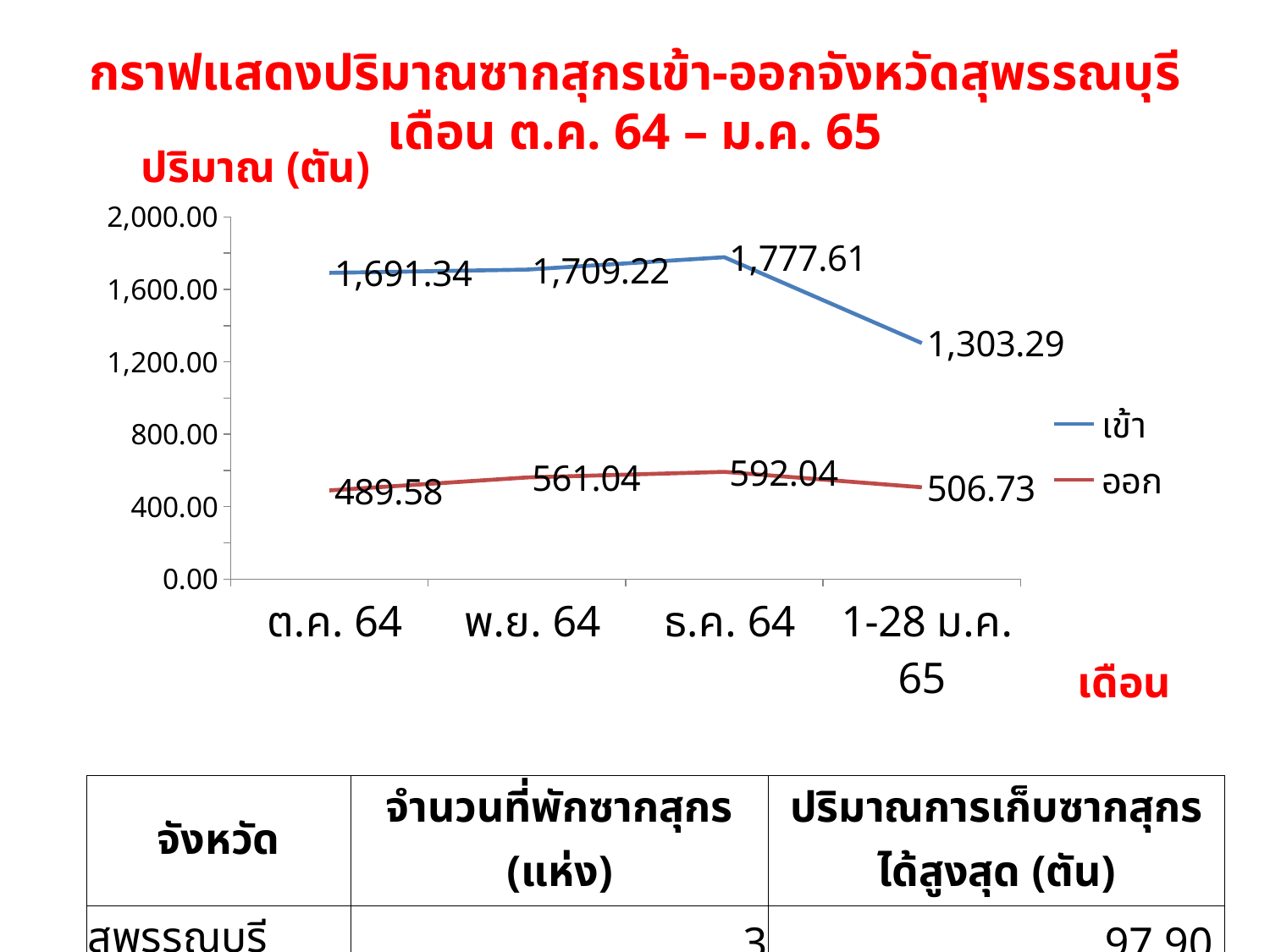
What is the value of เข้า for ธ.ค. 64? 1,777.61 What is the value of เข้า for 1-28 ม.ค. 65? 1,303.29 How many months are plotted along the x axis of the chart? 4 What is the difference between เข้า and ออก in พ.ย. 64? 1,148.18 Does the เข้า series rise or fall from ธ.ค. 64 to 1-28 ม.ค. 65? fall Which is larger, the ออก value for ธ.ค. 64 or the ออก value for 1-28 ม.ค. 65? ธ.ค. 64 What is the value of ออก for ต.ค. 64? 489.58 In which month is the ออก series lowest? ต.ค. 64 What is the label of the y axis of the chart? ปริมาณ (ตัน) What type of chart is shown on the slide? line chart How many series does the chart legend list? 2 In which month is the เข้า series highest? ธ.ค. 64